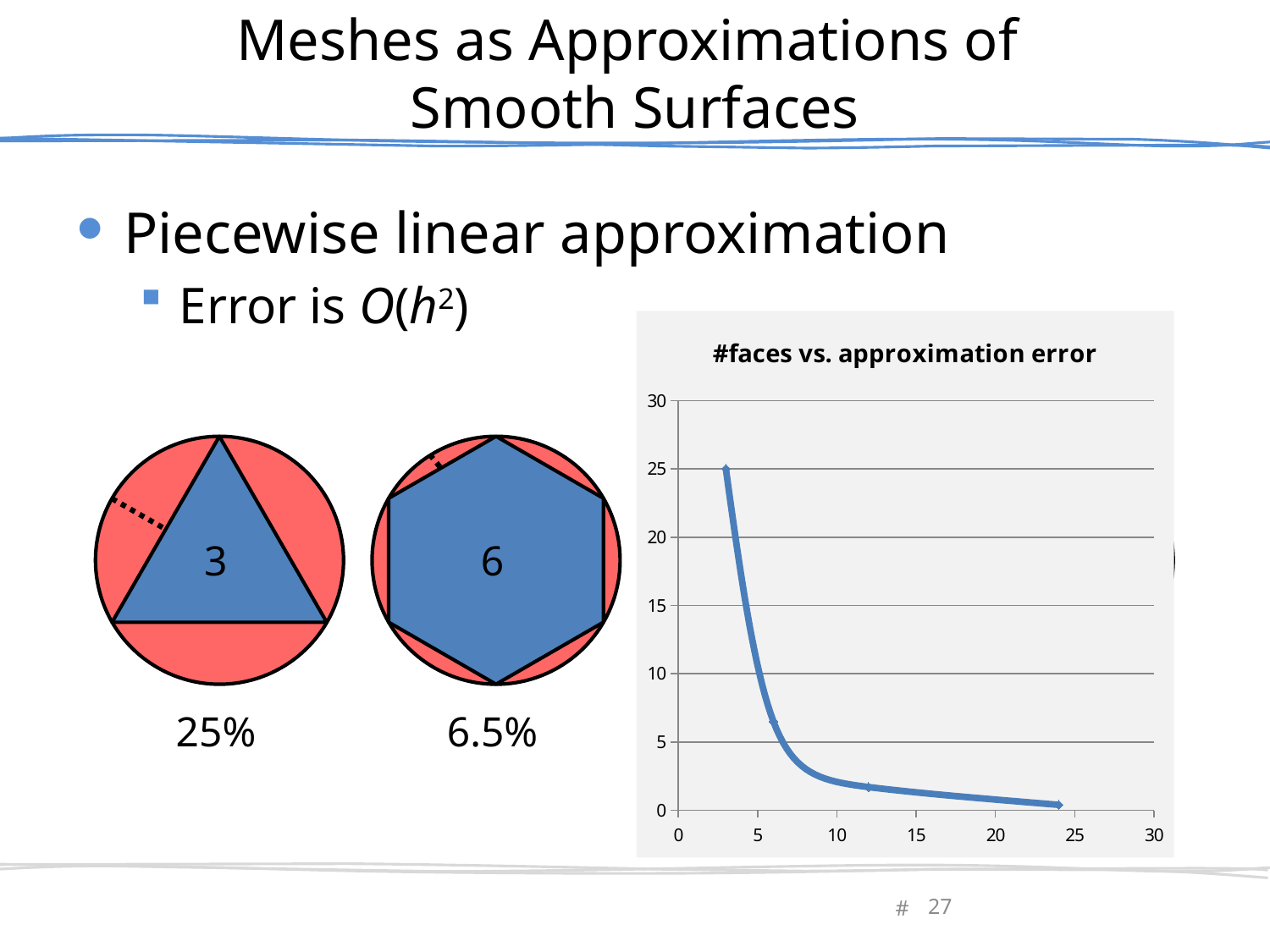
How many data points are plotted on the chart? 4 What is the approximation error plotted at x = 3? 25 What is the title of the chart? #faces vs. approximation error Do the values rise or fall as the number of faces increases along the x axis? fall What is the maximum value shown on the y axis of the chart? 30 Is the value plotted at x = 24 greater or less than 5? less At which x value (number of faces) is the approximation error highest? 3 Is the value plotted at x = 6 greater or less than 10? less Which has the larger approximation error, the point at x = 3 or the point at x = 12? x = 3 Is the value plotted at x = 3 greater or less than 20? greater What kind of chart is shown on the slide? line chart